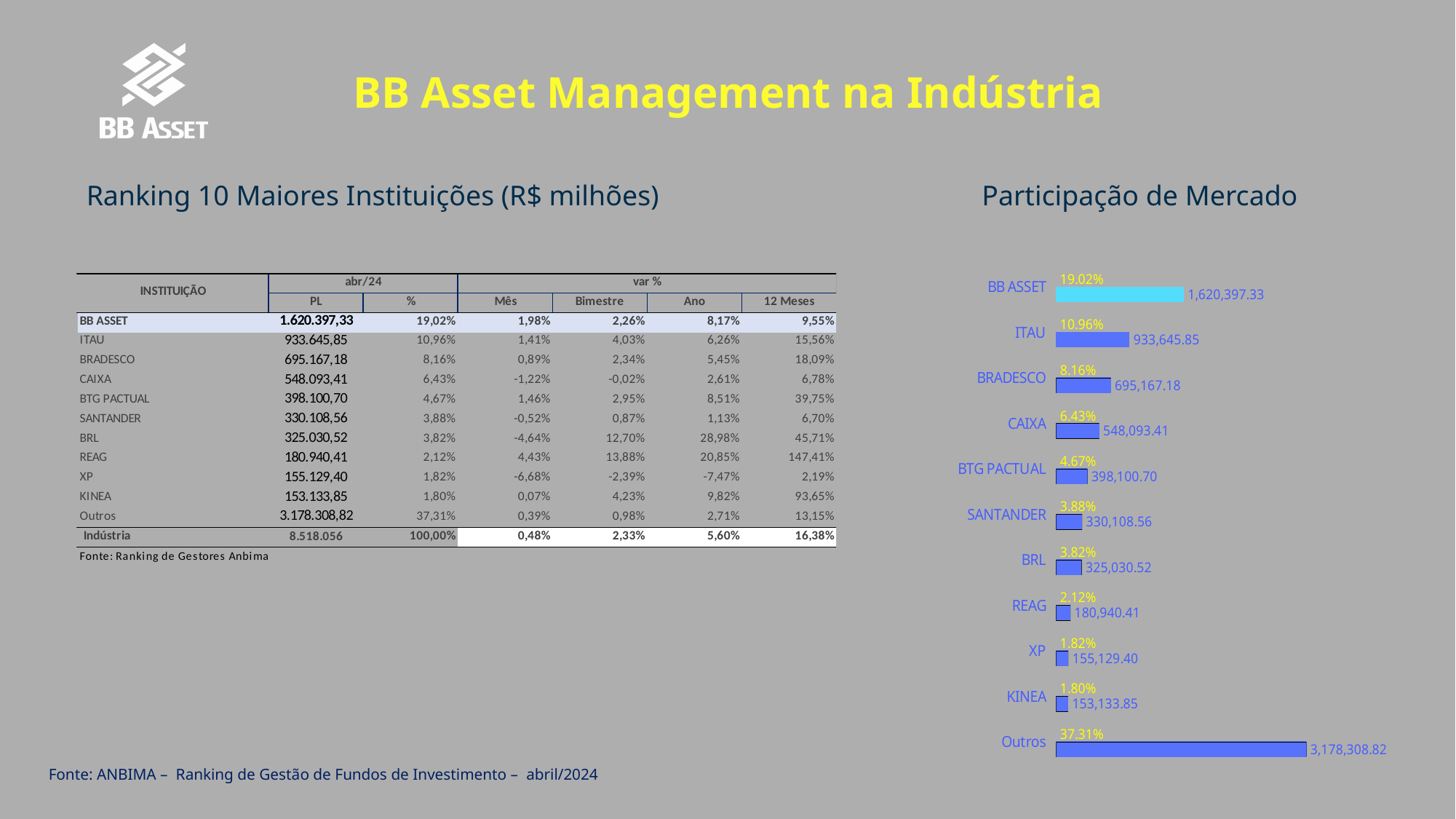
What is the title of the chart on the right side of the slide? Participação de Mercado In the Participação de Mercado chart, what is the difference between the values for BB ASSET and ITAU? 686,751.48 In the Participação de Mercado chart, how many percentage points higher is BB ASSET's share than ITAU's? 8.06% In the Participação de Mercado chart, what percentage is shown for Outros? 37.31% In the Participação de Mercado chart, which has the larger value, BRADESCO or CAIXA? BRADESCO In the Participação de Mercado chart, what value is shown for ITAU? 933,645.85 In the Participação de Mercado chart, which category has the longest bar? Outros In the Participação de Mercado chart, what percentage is shown for CAIXA? 6.43% In the Participação de Mercado chart, which category's bar is shown in a different (light blue) colour from the others? BB ASSET In the Participação de Mercado chart, which category has the smallest value? KINEA How many categories are shown in the Participação de Mercado chart? 11 What kind of chart is the Participação de Mercado chart? Bar chart